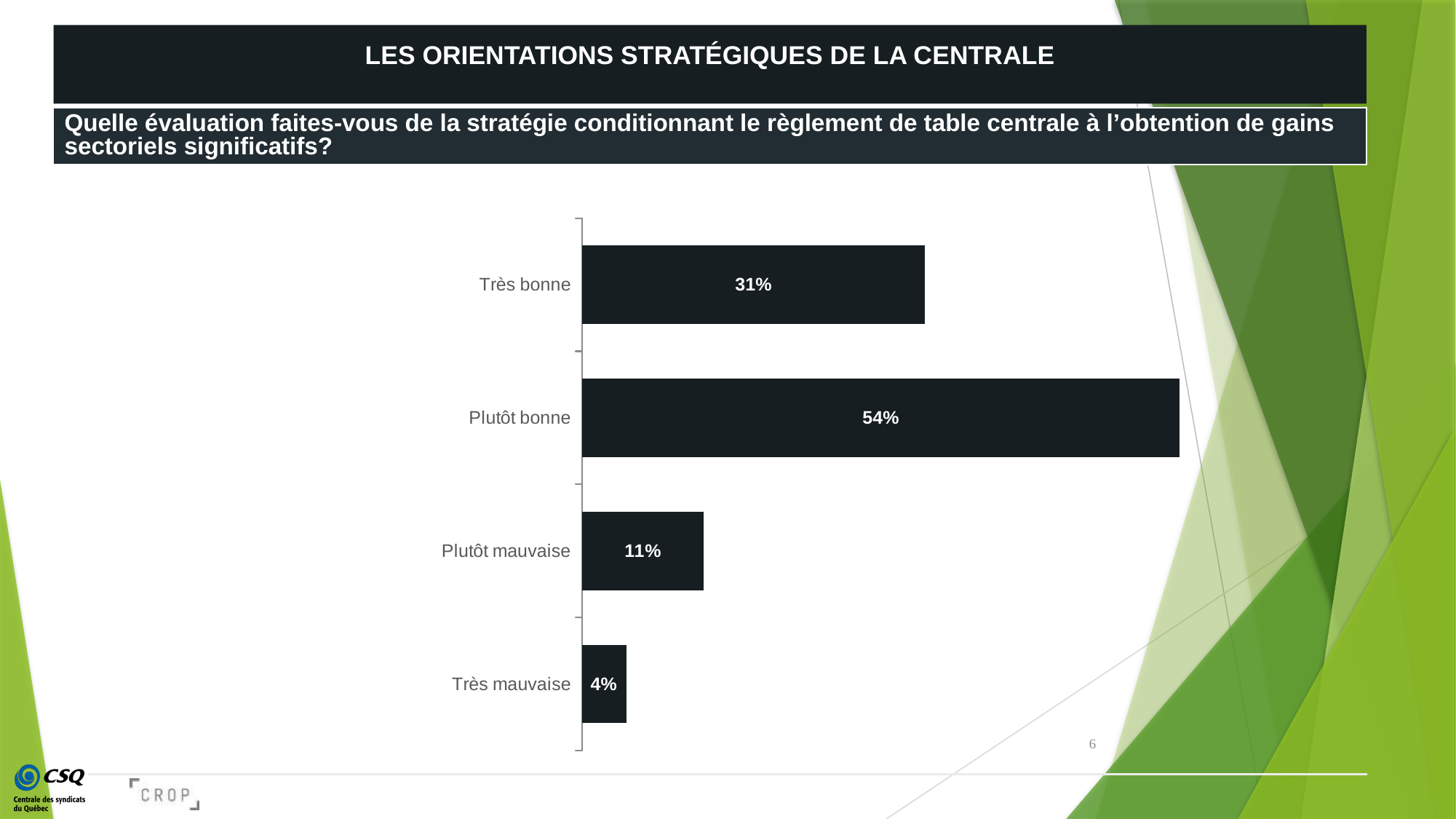
What is the value for "Plutôt mauvaise"? 11% Which category has the highest value? Plutôt bonne What is the value for "Plutôt bonne"? 54% What is the combined value of "Très bonne" and "Plutôt bonne"? 85% What is the difference between the values for "Plutôt bonne" and "Très bonne"? 23% What is the value for "Très bonne"? 31% What is the difference between the values for "Plutôt mauvaise" and "Très mauvaise"? 7% Which is larger, the value for "Très bonne" or the value for "Plutôt mauvaise"? Très bonne What is the value for "Très mauvaise"? 4% Which category has the lowest value? Très mauvaise What kind of chart is shown on the slide? Bar chart How many categories are shown in the chart? 4